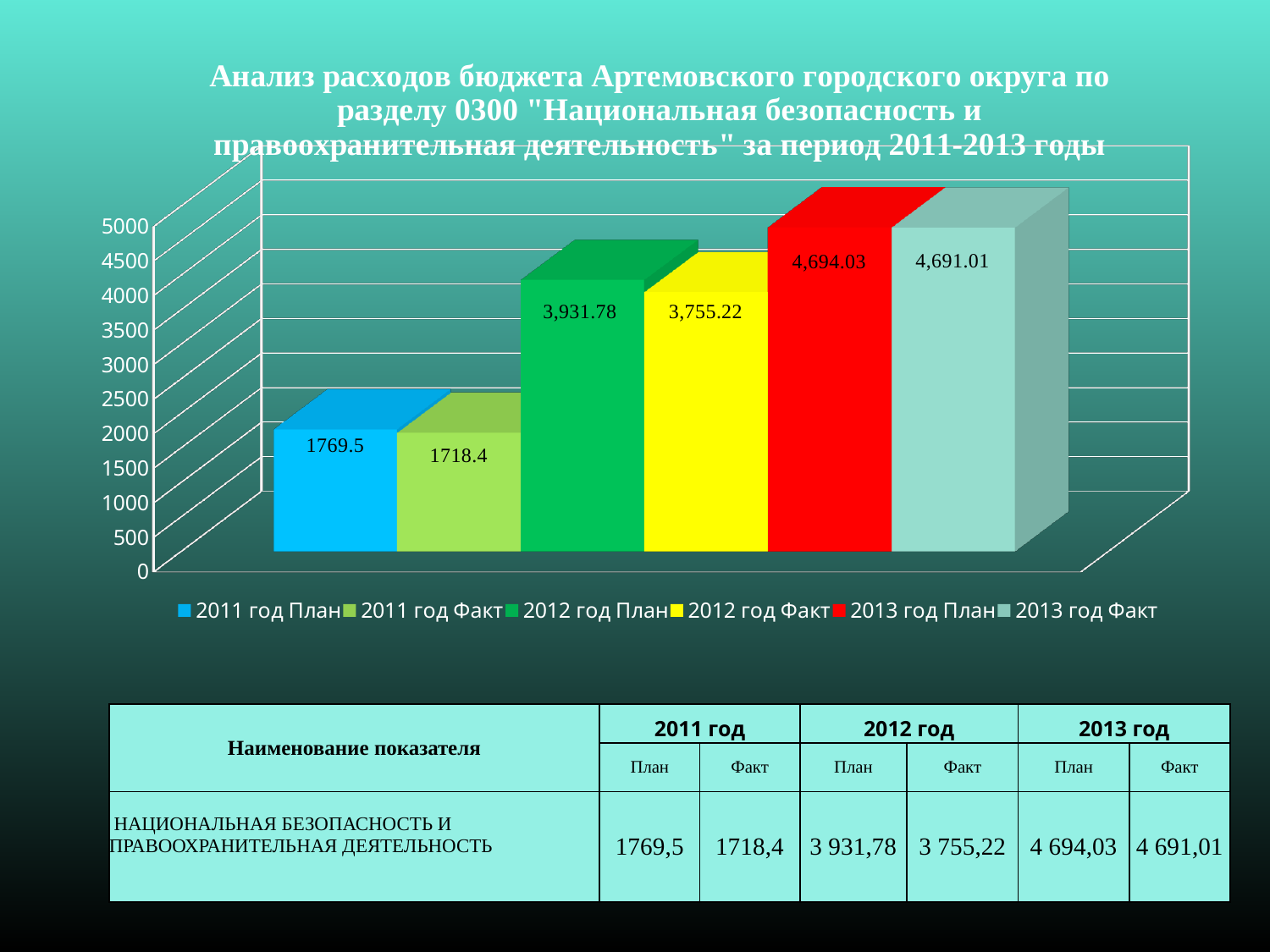
Is the value for 2011 год План greater or less than 2000? less What is the value for 2013 год Факт? 4,691.01 What is the value for 2011 год План? 1769.5 What is the value for 2013 год План? 4,694.03 What is the difference between 2011 год План and 2011 год Факт? 51.1 Which series has the lowest value? 2011 год Факт What is the value for 2012 год Факт? 3,755.22 Which is larger, 2012 год План or 2011 год План? 2012 год План What kind of chart is shown on the slide? bar chart Which series has the highest value? 2013 год План What is the difference between 2012 год План and 2012 год Факт? 176.56 How many series does the legend list? 6